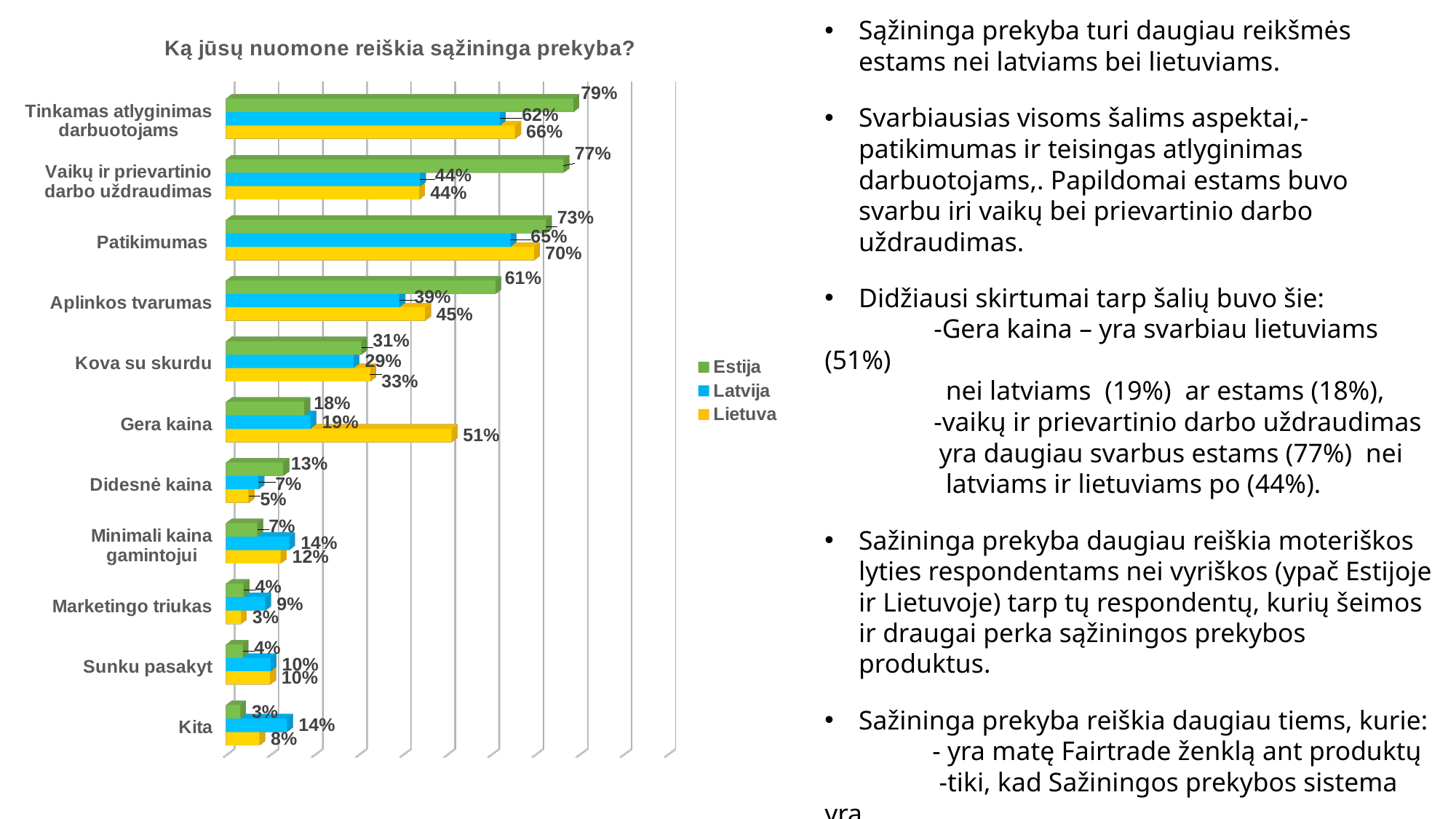
What is the difference between the Estija and Latvija values for Vaikų ir prievartinio darbo uždraudimas? 33% Which category has the highest value for Estija? Tinkamas atlyginimas darbuotojams What is the value for Lietuva in the Gera kaina category? 51% What is the title of the chart? Ką jūsų nuomone reiškia sąžininga prekyba? What kind of chart is shown on the slide? Bar chart Which category has the lowest value for Lietuva? Marketingo triukas Which colour represents Lietuva in the chart? Yellow Which is larger in the Kita category, the value for Latvija or the value for Lietuva? Latvija What is the value for Estija in the Tinkamas atlyginimas darbuotojams category? 79% What is the value for Latvija in the Patikimumas category? 65% How many series does the legend list? 3 How many categories are shown on the chart? 11